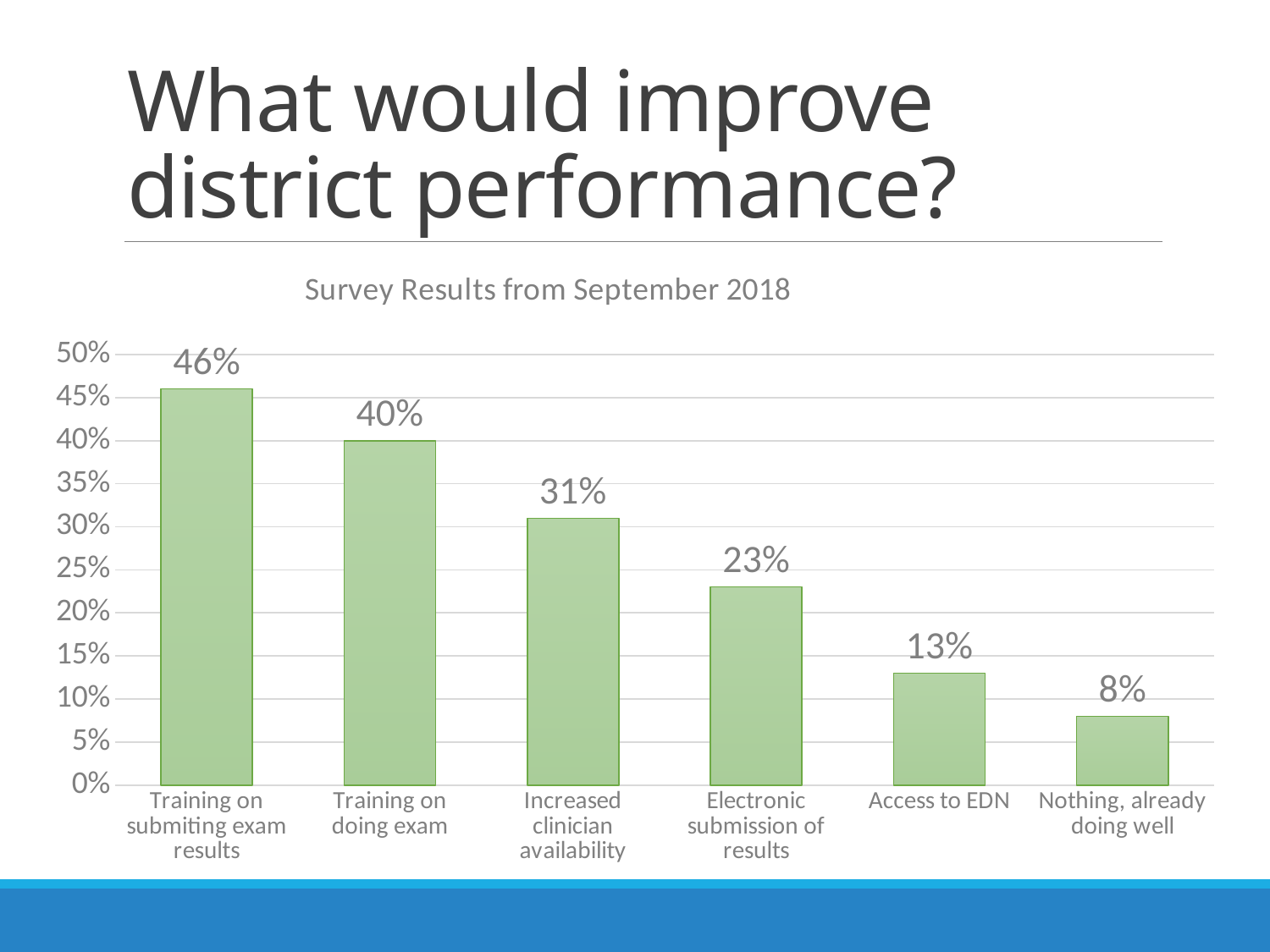
What is the value for "Training on submiting exam results"? 46% Do the values rise or fall from left to right along the x axis? Fall Which category has the lowest value? Nothing, already doing well Which is larger, "Electronic submission of results" or "Access to EDN"? Electronic submission of results Is the value for "Increased clinician availability" greater or less than 25%? greater What is the value for "Increased clinician availability"? 31% What is the value for "Access to EDN"? 13% What is the difference between "Training on doing exam" and "Electronic submission of results"? 17% What is the title of the chart? Survey Results from September 2018 How many categories are shown in the chart? 6 What kind of chart is shown on the slide? Bar chart Which category has the highest value? Training on submiting exam results